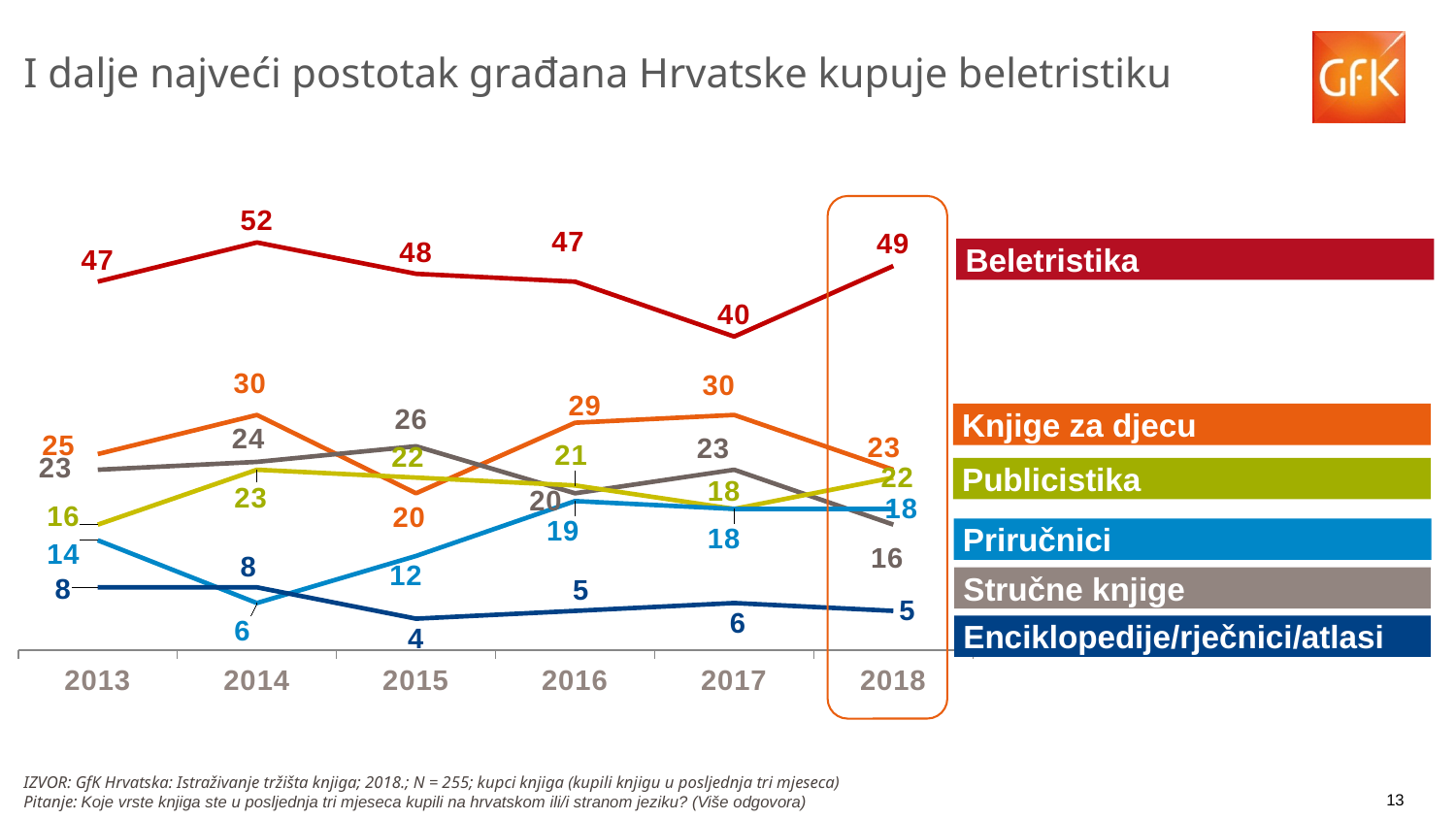
In which year does Beletristika have its lowest value? 2017 What is the value for Beletristika in 2018? 49 What is the difference between the Beletristika values in 2018 and 2017? 9 How many years are shown on the x axis? 6 How many series does the legend list? 6 Which is larger in 2018: Knjige za djecu or Publicistika? Knjige za djecu What kind of chart is shown on the slide? Line chart Which series is shown in dark red? Beletristika What is the value for Knjige za djecu in 2016? 29 What is the value for Enciklopedije/rječnici/atlasi in 2015? 4 In which year does Beletristika reach its highest value? 2014 What is the value for Stručne knjige in 2015? 26